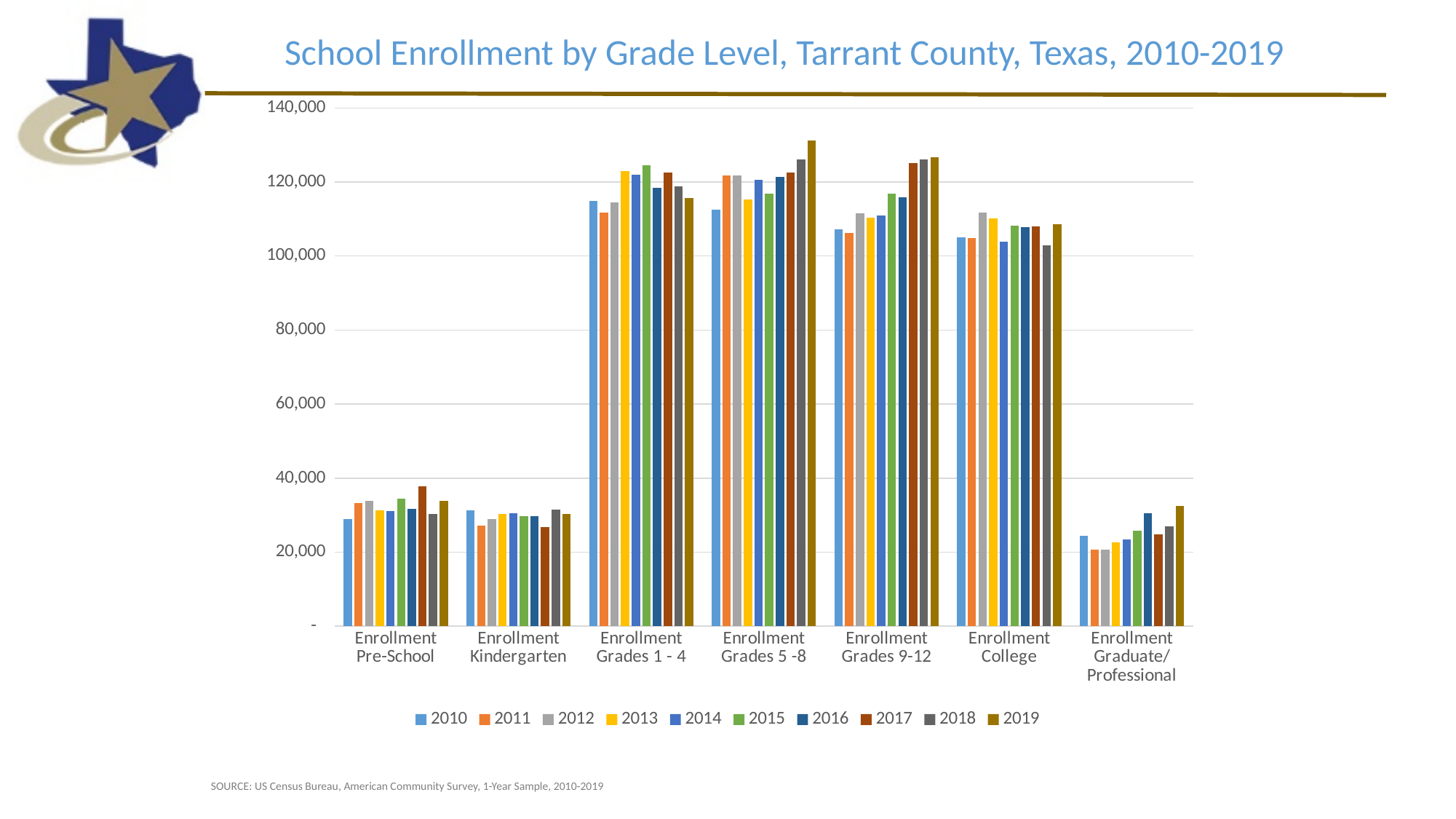
Which is larger: the 2017 value for Enrollment Pre-School or the 2010 value for Enrollment Pre-School? 2017 Which grade-level category has the lowest enrollment bars? Enrollment Graduate/Professional How many series (years) does the legend list? 10 What kind of chart is shown on the slide? Bar chart Is the 2017 value for Enrollment Pre-School greater or less than 40,000? less For Enrollment Grades 5 -8, do the values rise or fall from 2015 through 2019? rise Which grade-level category contains the tallest bar on the chart? Enrollment Grades 5 -8 Is the 2019 value for Enrollment Grades 5 -8 greater or less than 120,000? greater Is the 2019 value for Enrollment Graduate/Professional greater or less than 20,000? greater How many grade-level categories are shown along the x axis? 7 Which is larger: the 2019 value for Enrollment Graduate/Professional or the 2011 value for Enrollment Graduate/Professional? 2019 What is the title of the chart? School Enrollment by Grade Level, Tarrant County, Texas, 2010-2019